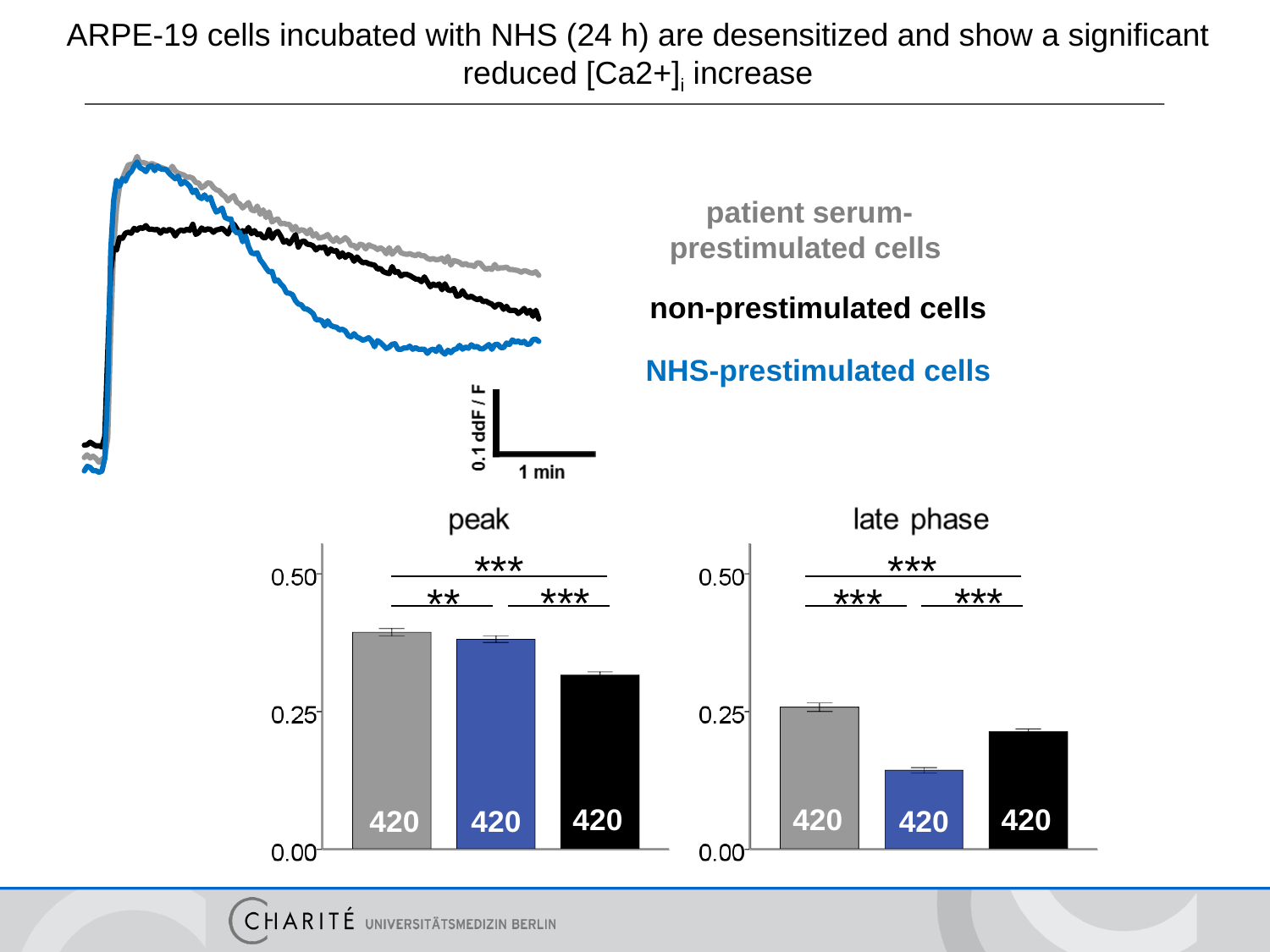
What number is printed inside each bar of the 'peak' chart? 420 How many bars does the 'late phase' chart show? 3 In the 'late phase' chart, which bar is the lowest? NHS-prestimulated cells (blue) In the 'peak' chart, which bar is the lowest? non-prestimulated cells (black) In the 'late phase' chart, is the value for NHS-prestimulated cells (blue bar) greater or less than 0.25? less In the 'late phase' chart, which is larger: the black bar (non-prestimulated cells) or the blue bar (NHS-prestimulated cells)? black bar (non-prestimulated cells) In the line chart at the top, which colour represents NHS-prestimulated cells? blue In the 'peak' chart, is the value for non-prestimulated cells (black bar) greater or less than 0.25? greater What kind of chart is the 'peak' chart? bar chart In the 'peak' chart, is the value for patient serum-prestimulated cells (gray bar) greater or less than 0.50? less In the 'late phase' chart, which bar is the highest? patient serum-prestimulated cells (gray)